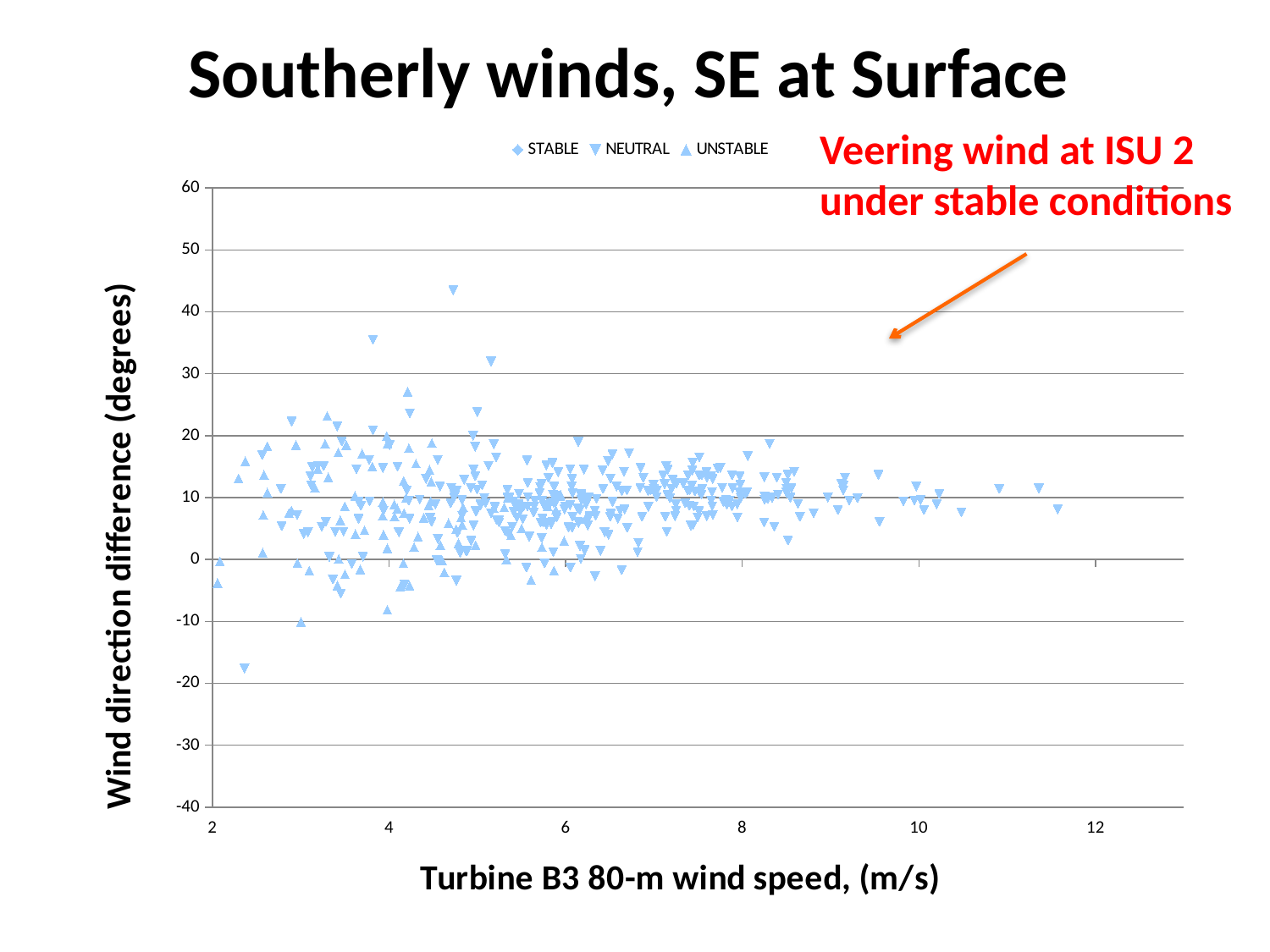
What are the three series named in the legend? STABLE, NEUTRAL, UNSTABLE Is the highest plotted wind direction difference greater or less than 50? less What is the title of the x axis? Turbine B3 80-m wind speed, (m/s) Is the lowest plotted wind direction difference greater or less than -10? less Is the lowest plotted wind direction difference greater or less than -20? greater What kind of chart is shown on the slide? scatter chart How many series does the legend list? 3